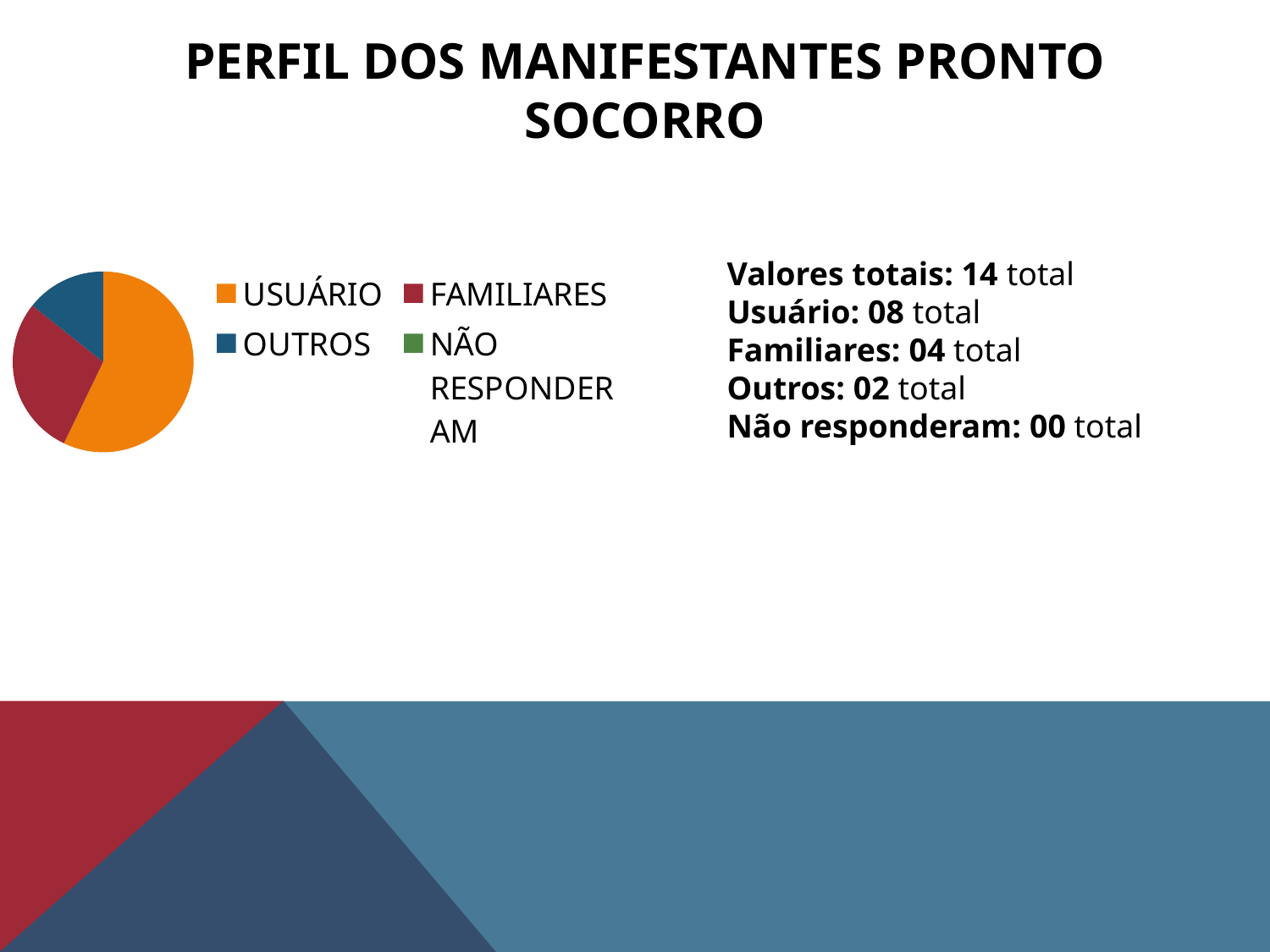
What kind of chart is shown on the slide? pie chart What is the value for Outros? 02 What is the difference between the values for Usuário and Familiares? 4 What is the value for Não responderam? 00 What colour is the USUÁRIO slice in the pie chart? orange How many categories does the pie chart's legend list? 4 What is the value for Familiares? 04 What is the total of all categories in the pie chart? 14 Which is larger, the value for Familiares or the value for Outros? FAMILIARES What is the value for Usuário? 08 Which category has the largest slice of the pie chart? USUÁRIO Which category has the smallest value in the pie chart? NÃO RESPONDERAM